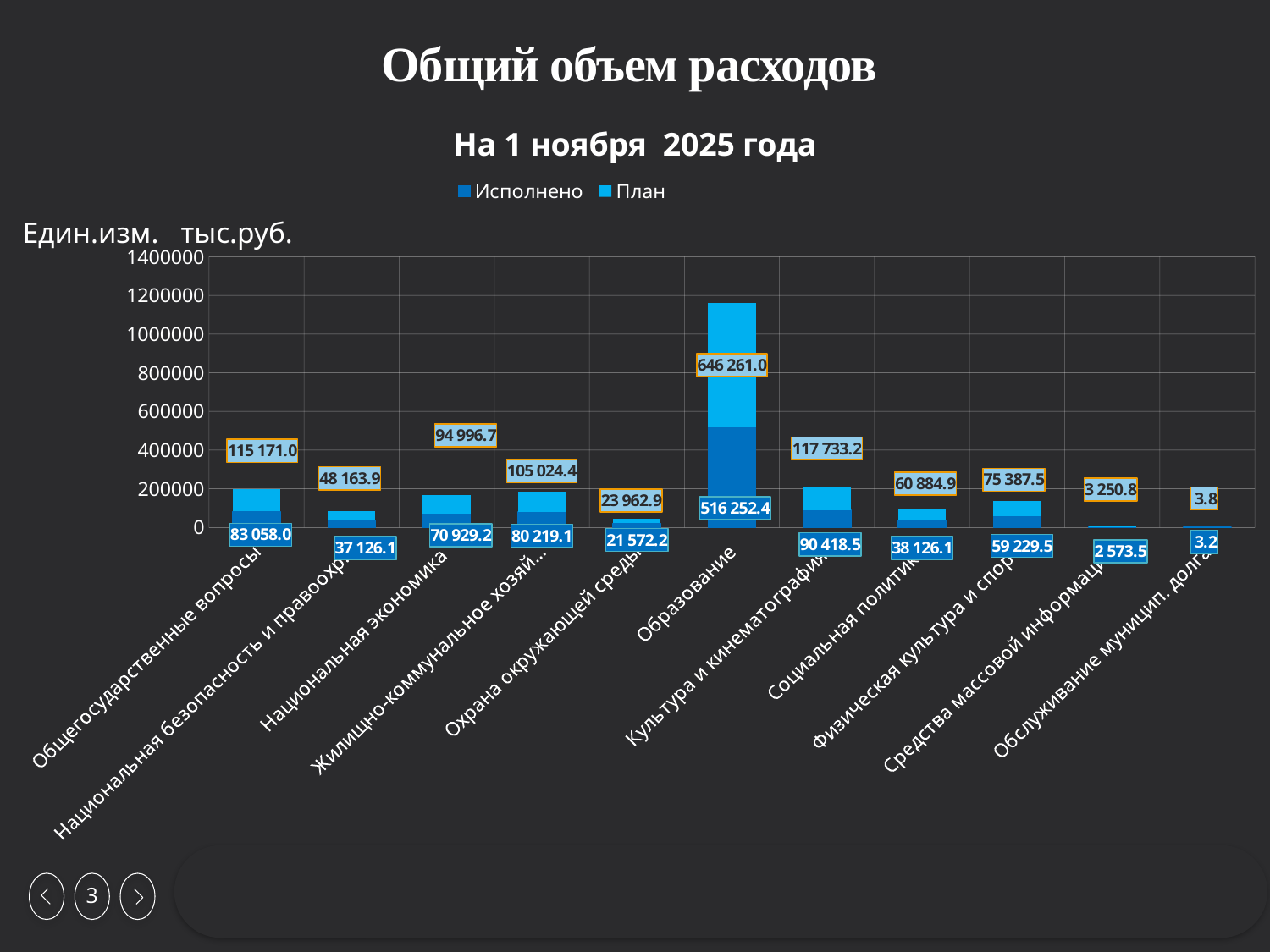
How many series does the legend list? 2 What is the Исполнено value for Охрана окружающей среды? 21 572.2 What is the План value for Образование? 646 261.0 What kind of chart is shown on the slide? Stacked bar chart What is the План value for Средства массовой информации? 3 250.8 What is the Исполнено value for Национальная экономика? 70 929.2 Is the total stacked bar for Образование greater or less than 1000000? greater What is the difference between the План and Исполнено values for Общегосударственные вопросы? 32 113.0 Which category has the lowest План value? Обслуживание муницип. долга Which category has the highest Исполнено value? Образование Which is larger: the Исполнено value for Социальная политика or the Исполнено value for Физическая культура и спорт? Физическая культура и спорт How many categories are shown on the x axis? 11